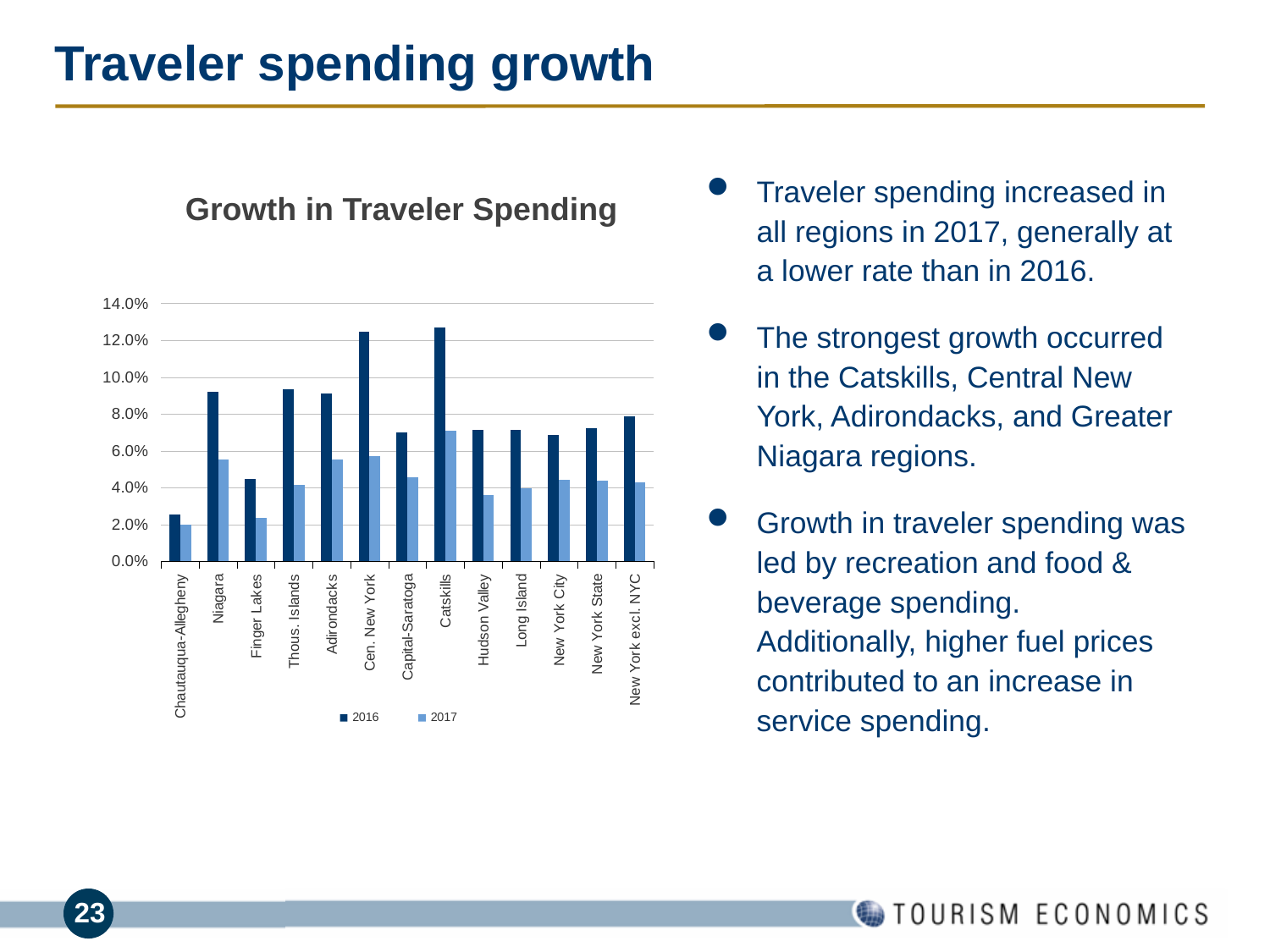
What type of chart is shown on the slide? Bar chart Which region has the lowest 2017 value in the chart? Chautauqua-Allegheny How many regions (categories) are shown on the x axis of the chart? 13 Which region has the lowest 2016 value in the chart? Chautauqua-Allegheny Which region has the highest 2017 value in the chart? Catskills What is the title of the chart? Growth in Traveler Spending Is the 2016 value for Catskills greater or less than 12.0%? greater Is the 2017 value for Hudson Valley greater or less than 4.0%? less Which is larger: the 2016 value for Niagara or the 2016 value for Finger Lakes? Niagara How many series does the chart's legend list? 2 Is the 2016 value for Chautauqua-Allegheny greater or less than 4.0%? less For Adirondacks, which series has the larger value, 2016 or 2017? 2016